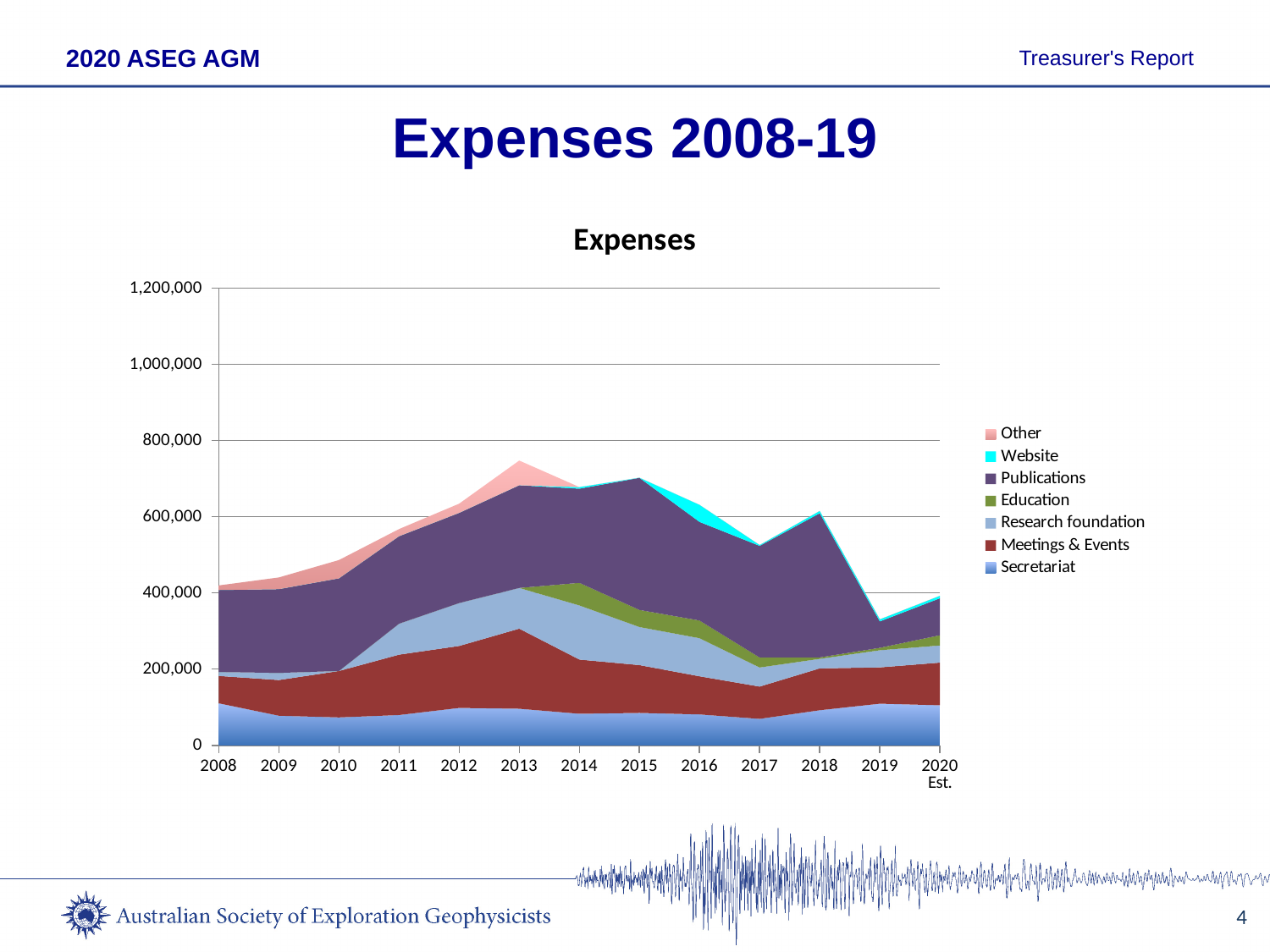
Which year has higher total expenses, 2017 or 2018? 2018 What kind of chart is shown on the slide? Area chart How many series does the legend of the Expenses chart list? 7 Is the total expenses for 2019 greater or less than 400,000? less What is the title of the chart on the slide? Expenses How many years are shown along the x axis of the Expenses chart? 13 Do total expenses rise or fall from 2008 to 2013 in the Expenses chart? rise Which series is at the bottom of the stack in the Expenses chart? Secretariat Is the total expenses for 2013 greater or less than 700,000? greater Is the total expenses for 2008 greater or less than 600,000? less In which year is the total expenses lowest in the Expenses chart? 2019 In which year is the total expenses highest in the Expenses chart? 2013